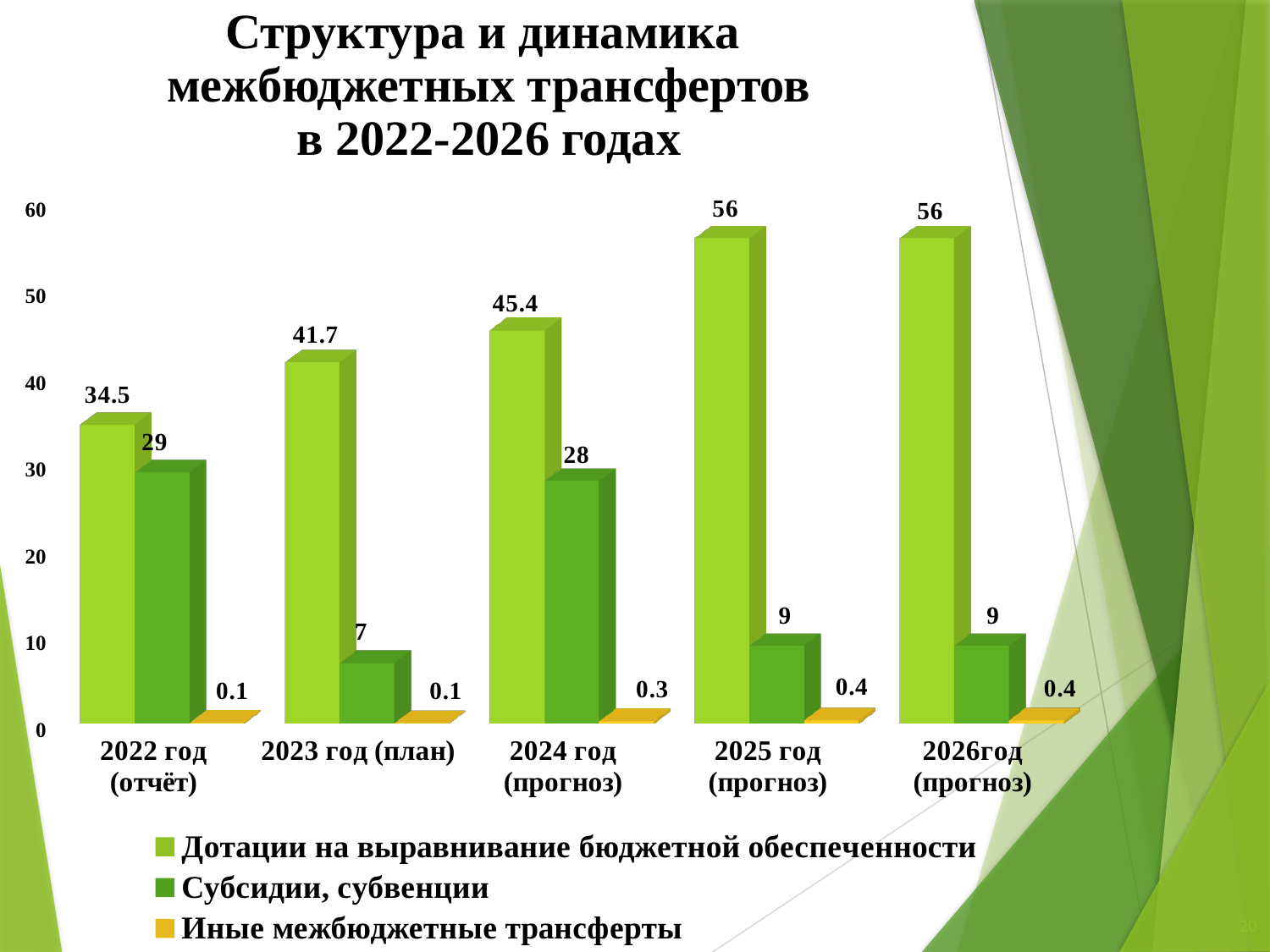
How many year categories are shown on the x axis? 5 Does the value of Дотации на выравнивание бюджетной обеспеченности rise or fall from 2022 to 2025? Rise What is the value of Субсидии, субвенции for 2023 год (план)? 7 Which year has the highest value for Субсидии, субвенции? 2022 год (отчёт) What is the value of Иные межбюджетные трансферты for 2025 год (прогноз)? 0.4 How many series does the legend list? 3 Which year has the lowest value for Дотации на выравнивание бюджетной обеспеченности? 2022 год (отчёт) What is the difference between the Дотации на выравнивание бюджетной обеспеченности values for 2024 год (прогноз) and 2023 год (план)? 3.7 Which is larger: Субсидии, субвенции for 2022 год (отчёт) or for 2024 год (прогноз)? 2022 год (отчёт) What is the value of Субсидии, субвенции for 2024 год (прогноз)? 28 What kind of chart is shown on the slide? Bar chart What is the value of Дотации на выравнивание бюджетной обеспеченности for 2022 год (отчёт)? 34.5